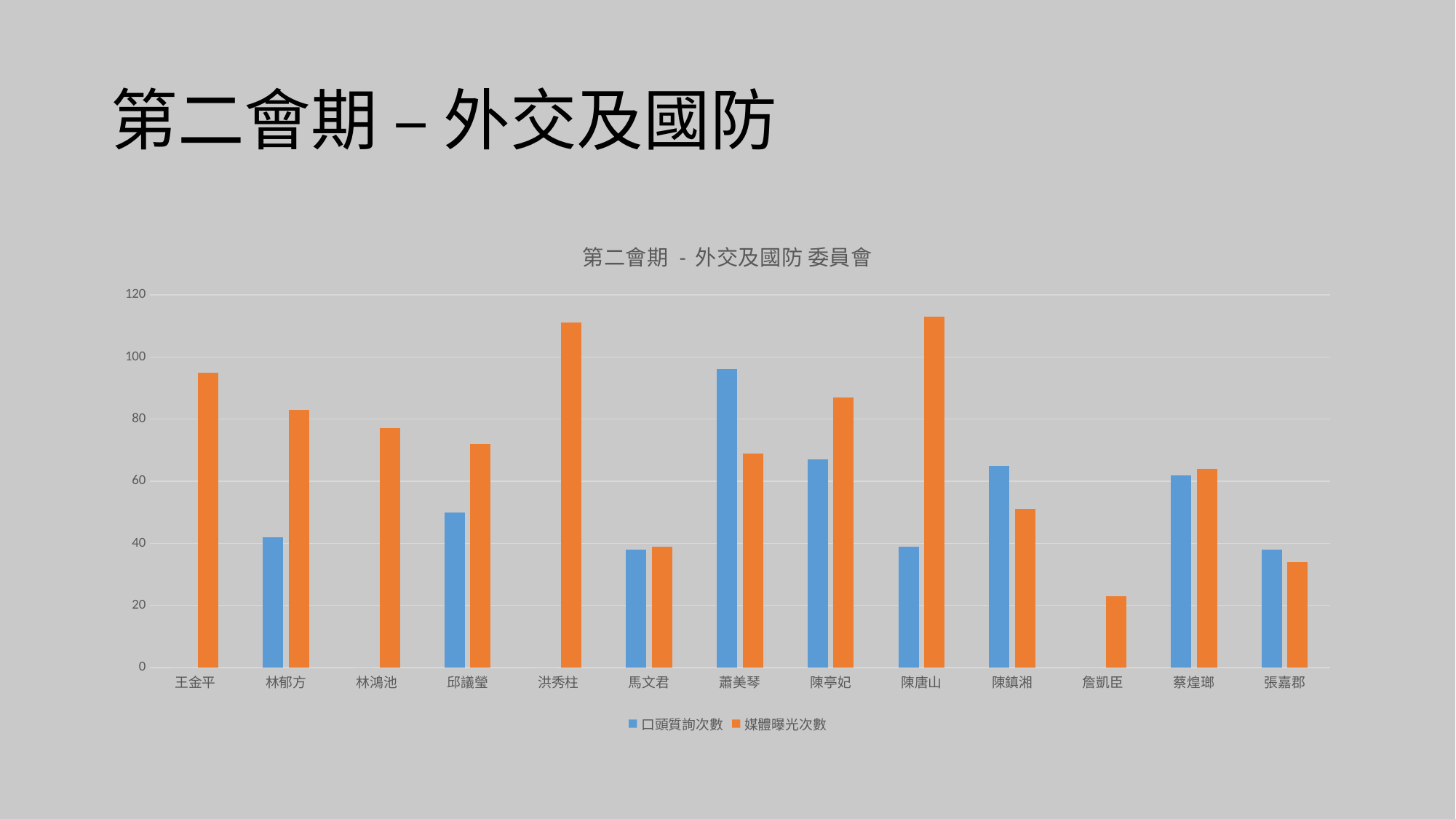
Which legislator has the highest 口頭質詢次數 value? 蕭美琴 How many series does the legend list? 2 Is the 媒體曝光次數 value for 詹凱臣 greater or less than 40? less What kind of chart is shown on the slide? bar chart What is the title of the chart? 第二會期 - 外交及國防 委員會 Is the 媒體曝光次數 value for 王金平 greater or less than 80? greater For 陳鎮湘, which is larger: 口頭質詢次數 or 媒體曝光次數? 口頭質詢次數 Is the 口頭質詢次數 value for 蕭美琴 greater or less than 80? greater For 陳亭妃, which is larger: 口頭質詢次數 or 媒體曝光次數? 媒體曝光次數 Which legislator has the lowest 媒體曝光次數 value? 詹凱臣 How many legislators (categories) are shown on the x axis? 13